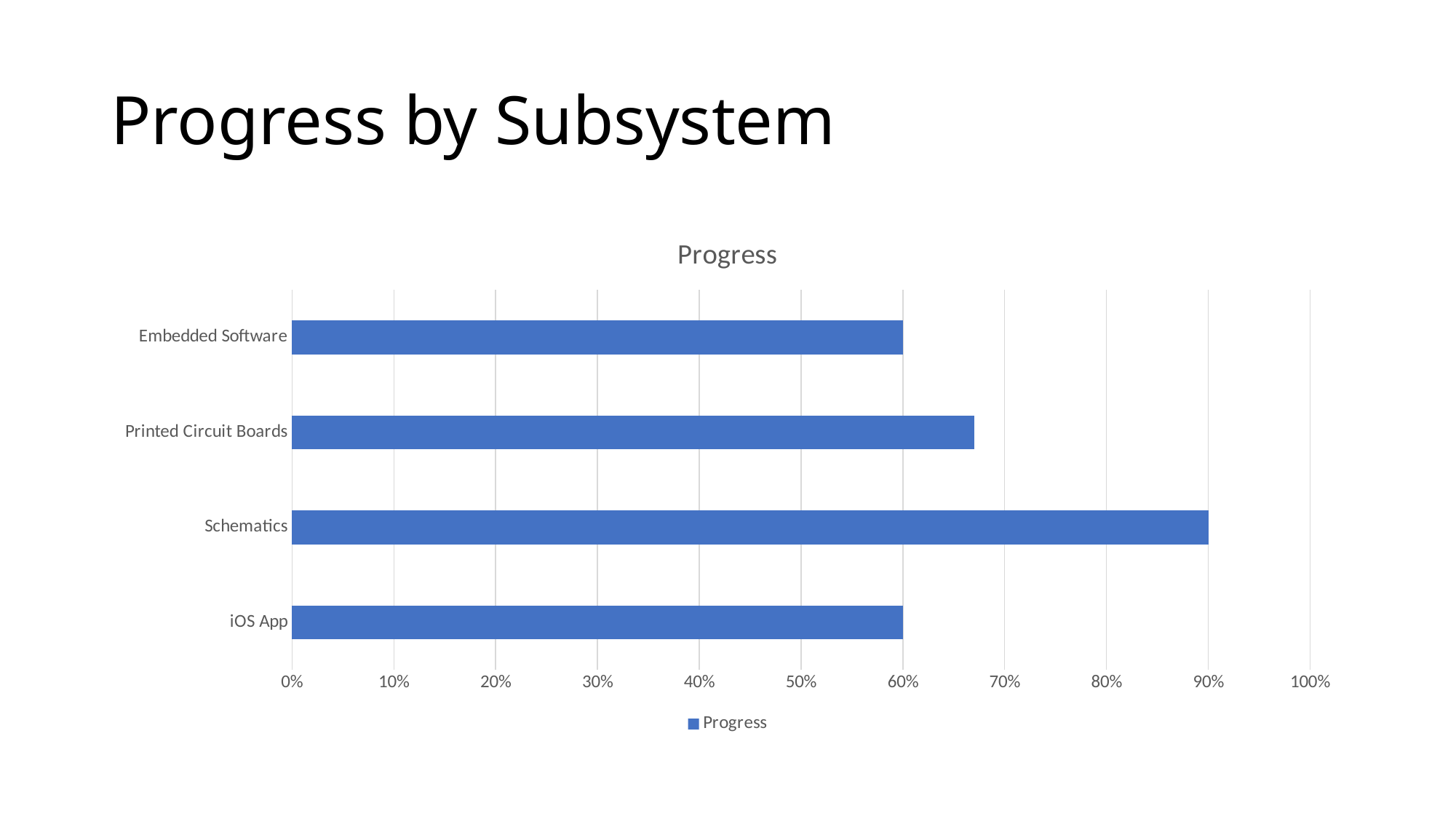
What kind of chart is shown on the slide? bar chart What is the progress value for iOS App? 60% What is the title of the chart? Progress Is the progress value for Printed Circuit Boards greater or less than 60%? greater How many subsystems (categories) are plotted in the chart? 4 What is the difference in progress between Schematics and iOS App? 30% What is the progress value for Embedded Software? 60% Which has higher progress, Printed Circuit Boards or Embedded Software? Printed Circuit Boards How many series does the legend list? 1 Is the progress value for Printed Circuit Boards greater or less than 70%? less What is the progress value for Schematics? 90% Which subsystem has the highest progress? Schematics